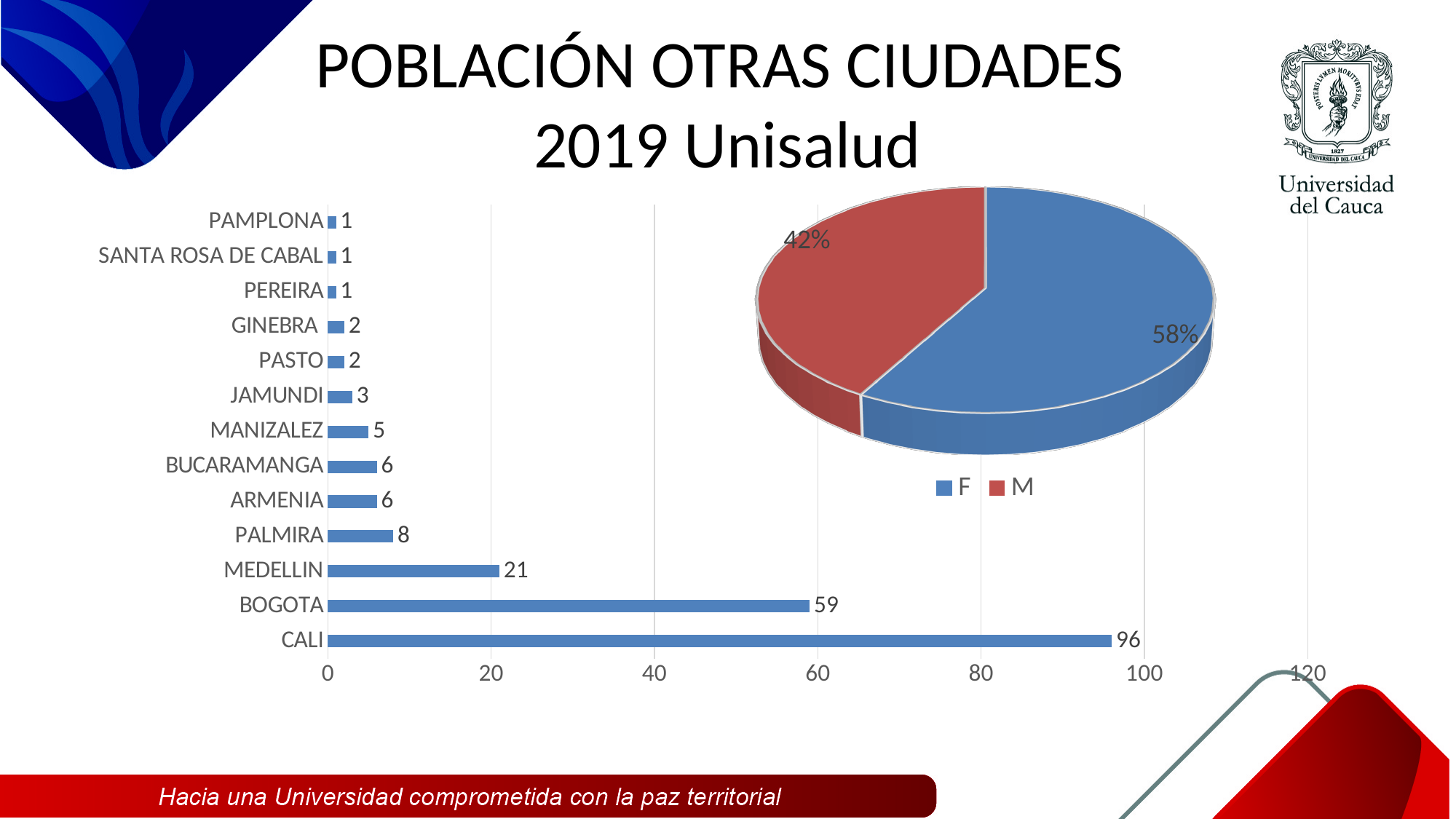
What kind of chart is the chart on the left? bar chart How many cities are shown in the bar chart on the left? 13 In the pie chart on the right, what share does F have? 58% In the bar chart on the left, which city has the highest value? CALI In the pie chart on the right, which colour represents M? red In the bar chart on the left, what is the difference between the values for CALI and BOGOTA? 37 In the bar chart on the left, which is larger, the value for PALMIRA or the value for JAMUNDI? PALMIRA In the bar chart on the left, what is the value for MEDELLIN? 21 In the pie chart on the right, what share does M have? 42% How many series does the legend of the pie chart on the right list? 2 In the bar chart on the left, what is the value for CALI? 96 In the bar chart on the left, is the value for BOGOTA greater or less than 40? greater